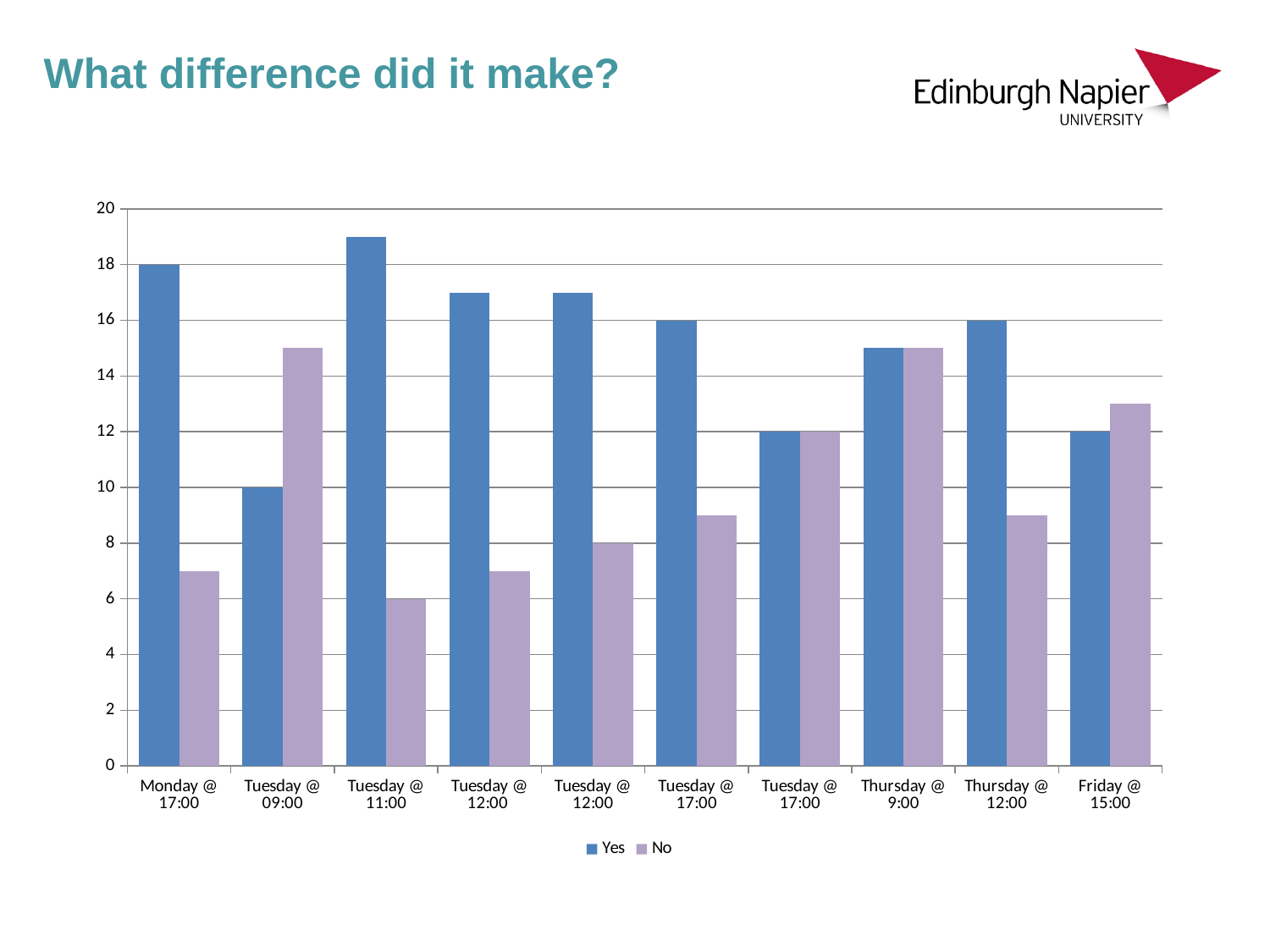
How many categories are shown on the x axis? 10 How many series does the legend list? 2 What is the Yes value for Thursday @ 12:00? 16 Which category has the highest Yes value? Tuesday @ 11:00 What is the Yes value for Tuesday @ 09:00? 10 What type of chart is shown on the slide? bar chart What is the No value for Tuesday @ 11:00? 6 For Tuesday @ 09:00, which is larger, Yes or No? No What is the difference between the Yes value for Monday @ 17:00 and the No value for Tuesday @ 11:00? 12 What is the Yes value for Monday @ 17:00? 18 Is the No value for Monday @ 17:00 greater or less than 8? less Which category has the lowest No value? Tuesday @ 11:00